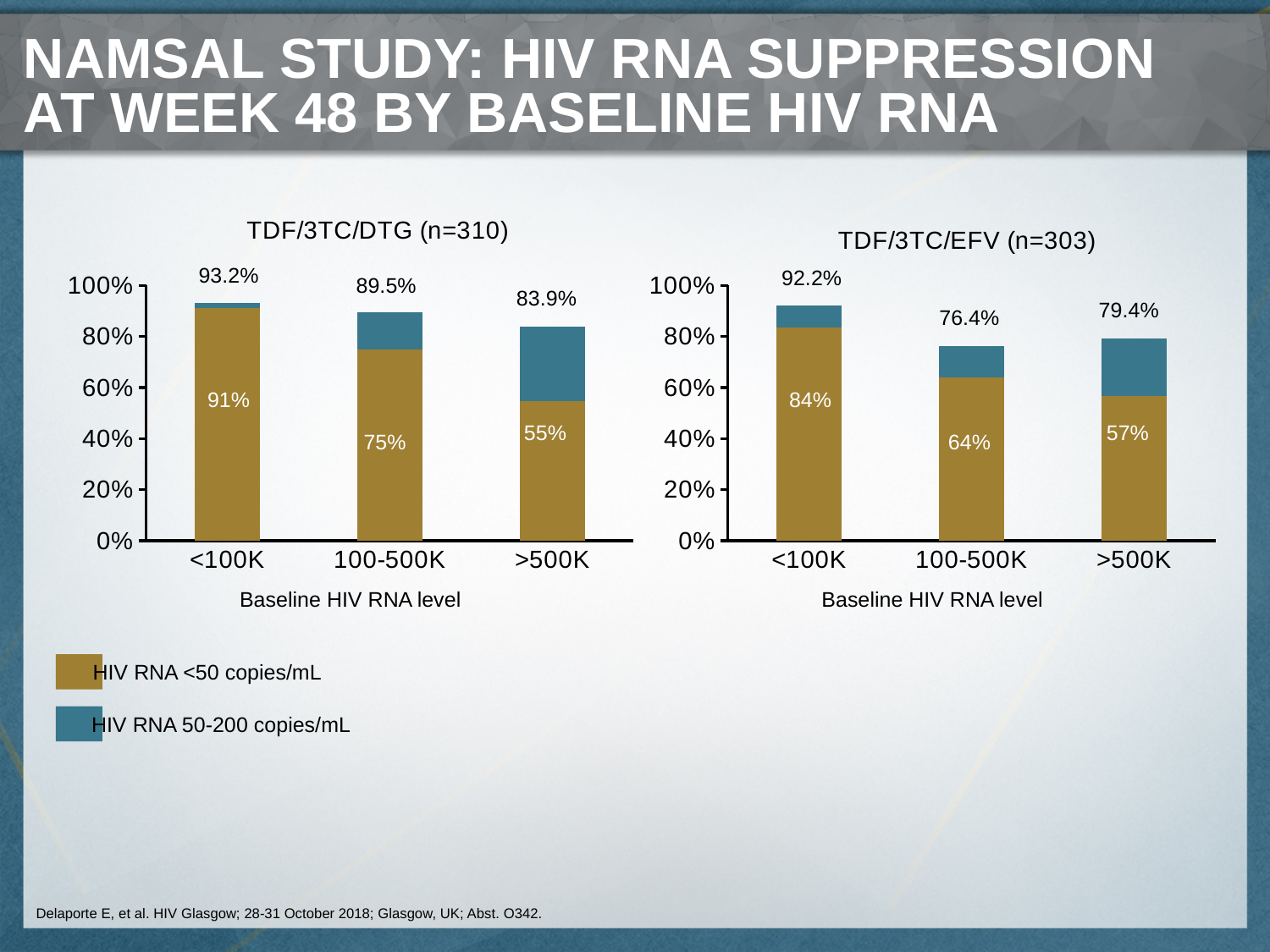
How many baseline HIV RNA level categories are shown in each chart? 3 In the TDF/3TC/EFV (n=303) chart, what is the total labelled above the <100K bar? 92.2% Which is larger: the HIV RNA <50 copies/mL value for 100-500K in the TDF/3TC/DTG chart or in the TDF/3TC/EFV chart? TDF/3TC/DTG (75%) How many series does the legend list? 2 In the TDF/3TC/EFV (n=303) chart, is the total for the 100-500K group greater or less than 80%? less What kind of chart is used on this slide? Stacked bar chart In the TDF/3TC/DTG (n=310) chart, what is the total labelled above the >500K bar? 83.9% In the TDF/3TC/EFV (n=303) chart, which baseline HIV RNA group has the highest total bar? <100K In the TDF/3TC/DTG (n=310) chart, which baseline HIV RNA group has the lowest HIV RNA <50 copies/mL value? >500K In the TDF/3TC/DTG (n=310) chart, what is the difference between the total for <100K (93.2%) and the total for >500K (83.9%)? 9.3 percentage points In the TDF/3TC/EFV (n=303) chart, what is the HIV RNA <50 copies/mL value for the 100-500K baseline group? 64% In the TDF/3TC/DTG (n=310) chart, what is the HIV RNA <50 copies/mL value for the <100K baseline group? 91%